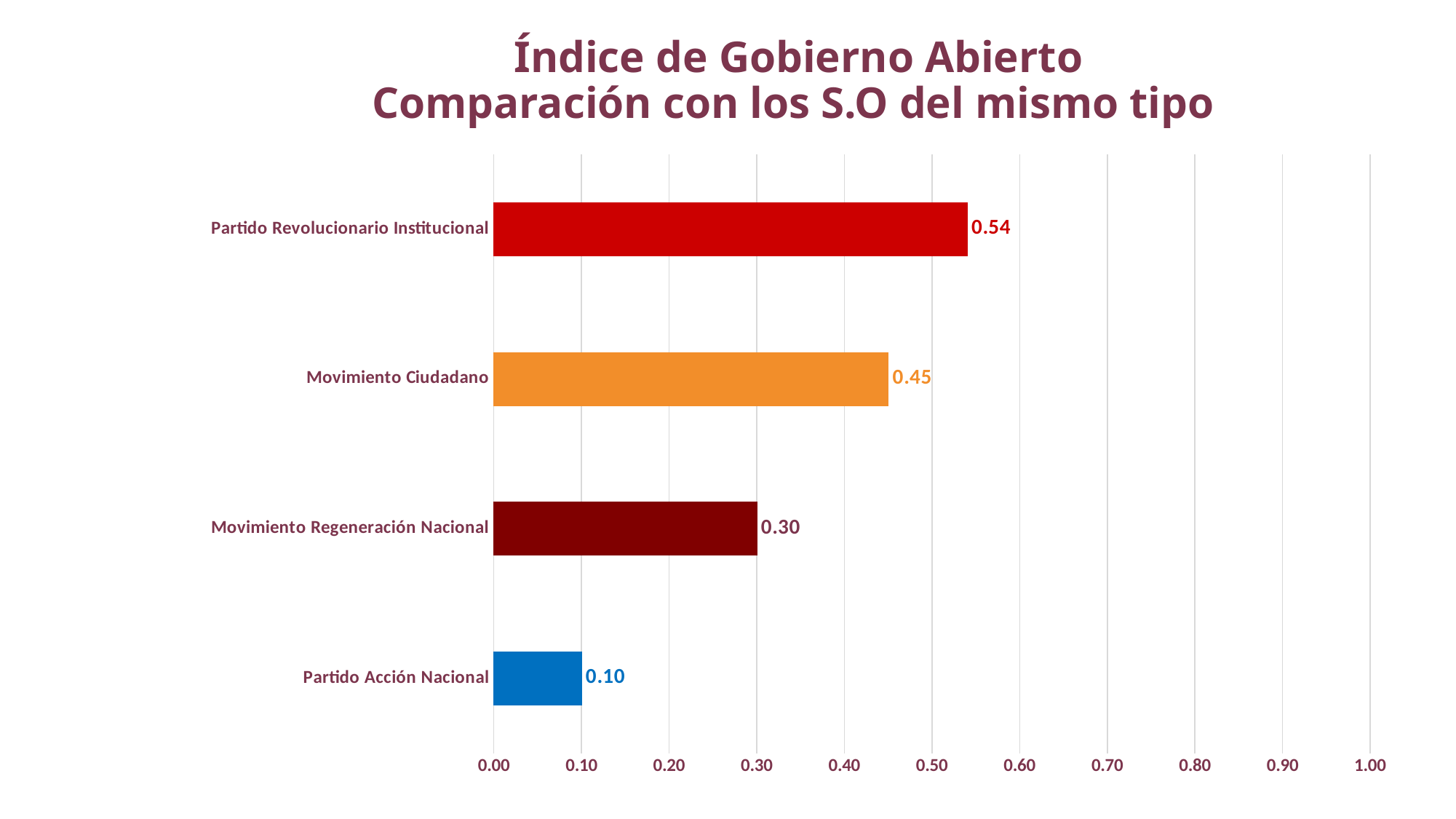
Which is larger, the value for Movimiento Ciudadano or the value for Movimiento Regeneración Nacional? Movimiento Ciudadano Which category has the lowest value? Partido Acción Nacional What is the value for Partido Acción Nacional? 0.10 What is the value for Movimiento Regeneración Nacional? 0.30 What is the value for Partido Revolucionario Institucional? 0.54 How many categories are shown in the chart? 4 What is the title of the chart? Índice de Gobierno Abierto Comparación con los S.O del mismo tipo What kind of chart is shown on the slide? Bar chart What is the difference between the values for Movimiento Regeneración Nacional and Partido Acción Nacional? 0.20 What is the difference between the values for Partido Revolucionario Institucional and Movimiento Ciudadano? 0.09 Which category has the highest value? Partido Revolucionario Institucional What is the value for Movimiento Ciudadano? 0.45